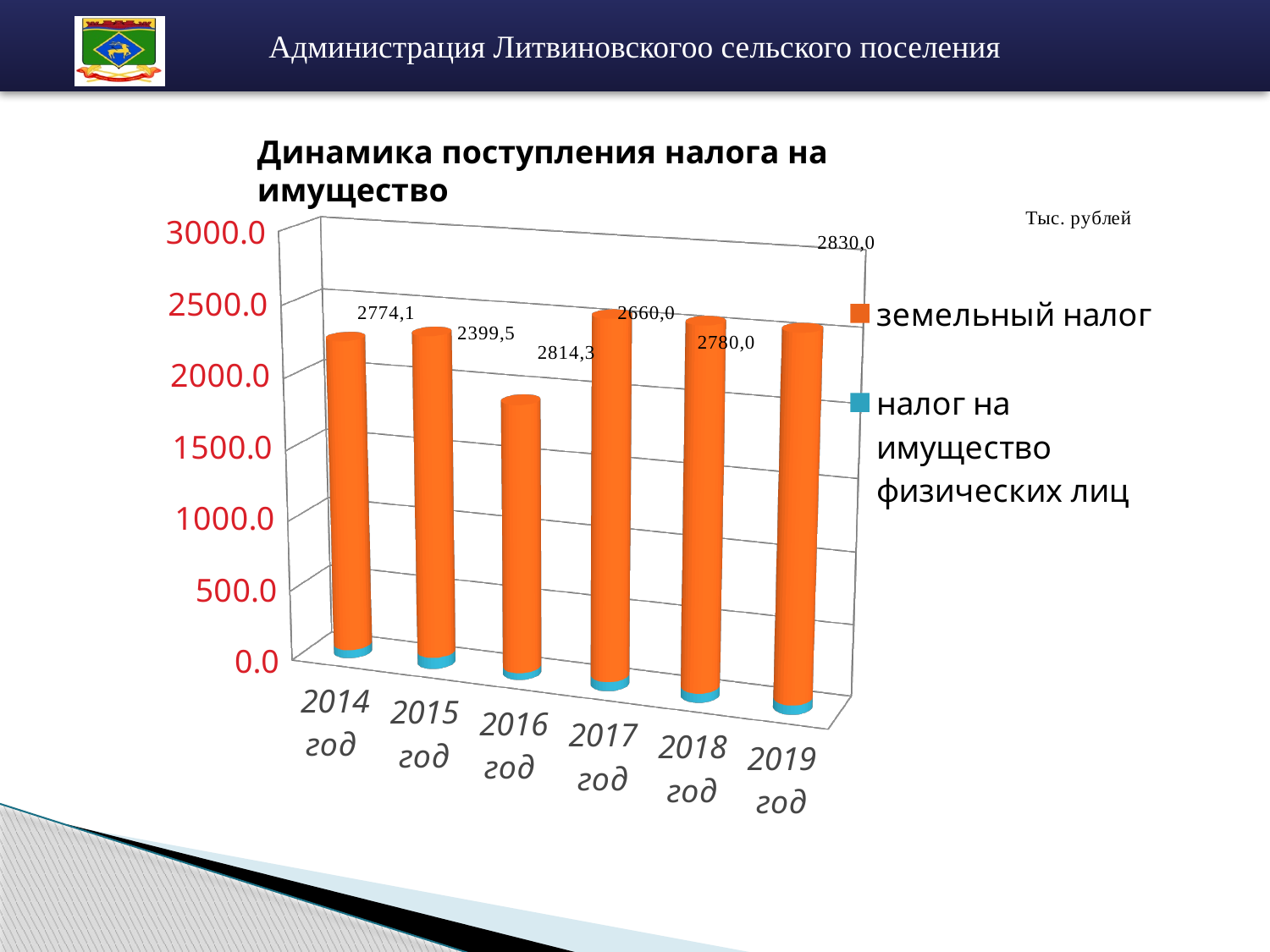
What type of chart is shown on the slide? bar chart What value is labelled for 2019 год in the chart? 2830,0 What is the unit of measurement indicated for the chart values? Тыс. рублей What value is labelled for 2014 год in the chart? 2774,1 What value is labelled for 2016 год in the chart? 2814,3 How many years are shown on the x axis of the chart? 6 What value is labelled for 2015 год in the chart? 2399,5 How many series does the chart legend list? 2 What is the title of the chart? Динамика поступления налога на имущество What value is labelled for 2017 год in the chart? 2660,0 Which series is shown in orange in the chart? земельный налог What value is labelled for 2018 год in the chart? 2780,0